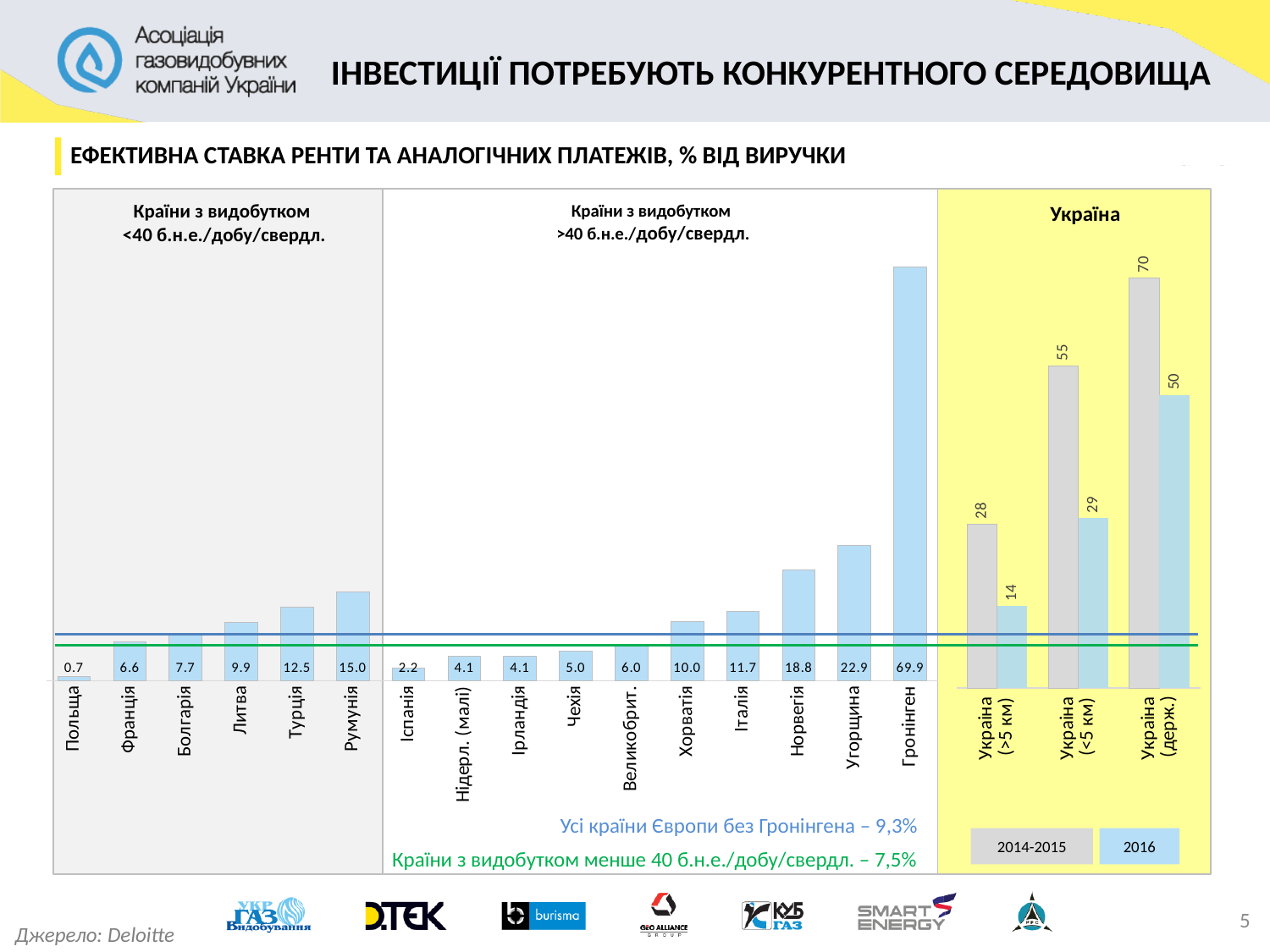
What kind of chart is shown on the slide? Bar chart What is the value shown for Гронінген? 69.9 What is the 2014-2015 value for Україна (<5 км)? 55 Among the countries in the group with production <40 б.н.е./добу/свердл., which has the highest value? Румунія What is the value shown for Польща? 0.7 According to the text on the chart, what is the effective rate for all European countries without Гронінген? 9,3% How many series does the legend list? 2 Which has a larger value, Турція or Італія? Турція What is the difference between the values for Угорщина and Норвегія? 4.1 What is the 2016 value for Україна (держ.)? 50 Among the countries in the group with production >40 б.н.е./добу/свердл., which has the lowest value? Іспанія What is the difference between the 2014-2015 and 2016 values for Україна (>5 км)? 14